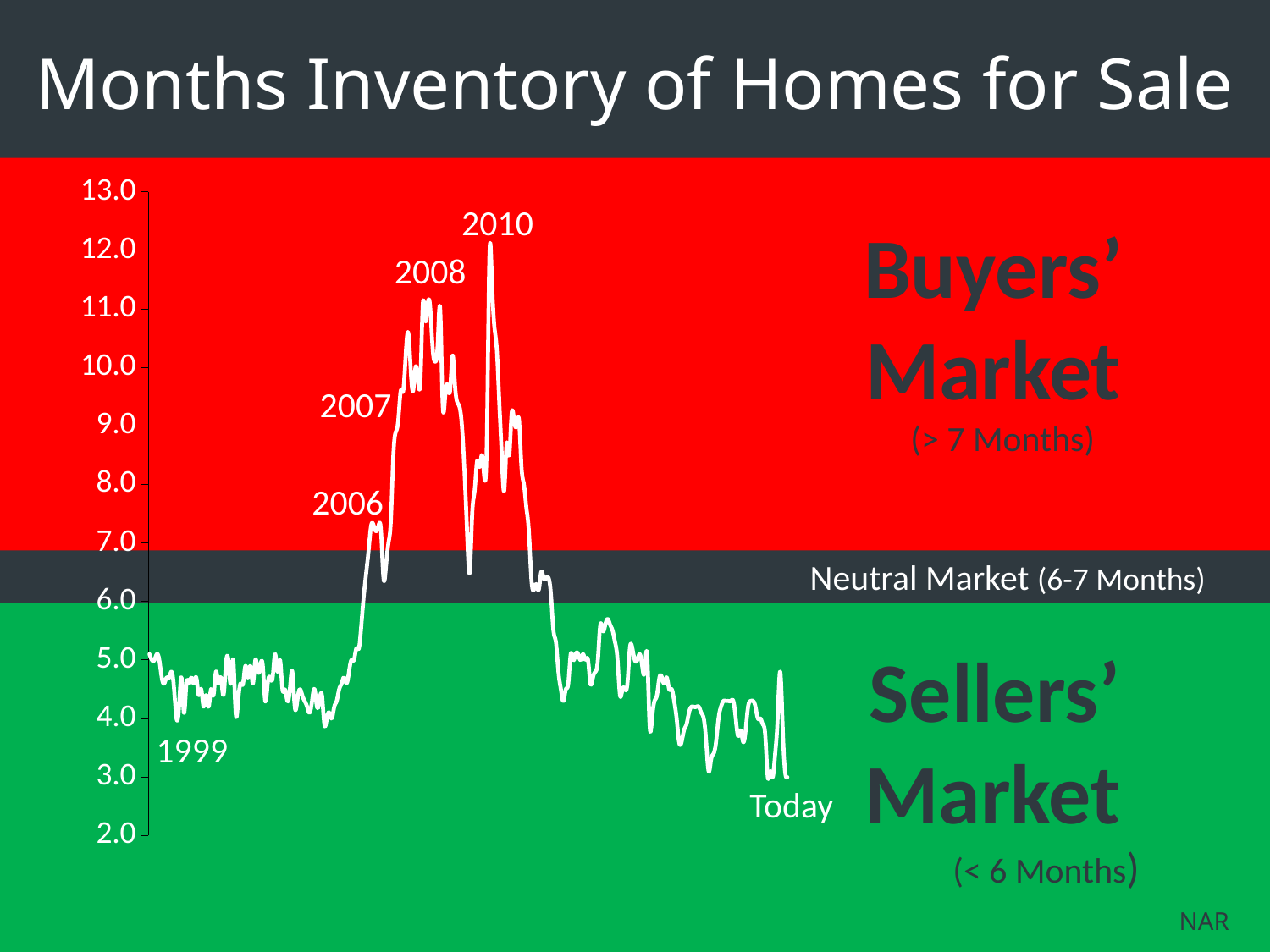
Which is higher, the value labeled 2006 or the value labeled Today? 2006 Is the peak value labeled 2010 greater or less than 11.0? greater According to the slide, what months-of-inventory range defines a Neutral Market? 6-7 Months Which is higher, the peak labeled 2010 or the peak labeled 2008? 2010 Is the value labeled Today greater or less than 4.0? less What is the title of the chart? Months Inventory of Homes for Sale Does the line rise or fall from the 2010 peak to Today? fall What kind of chart is shown on the slide? line chart Is the peak value labeled 2008 greater or less than 10.0? greater Which labeled year marks the highest peak on the line? 2010 How many lines are plotted on the chart? 1